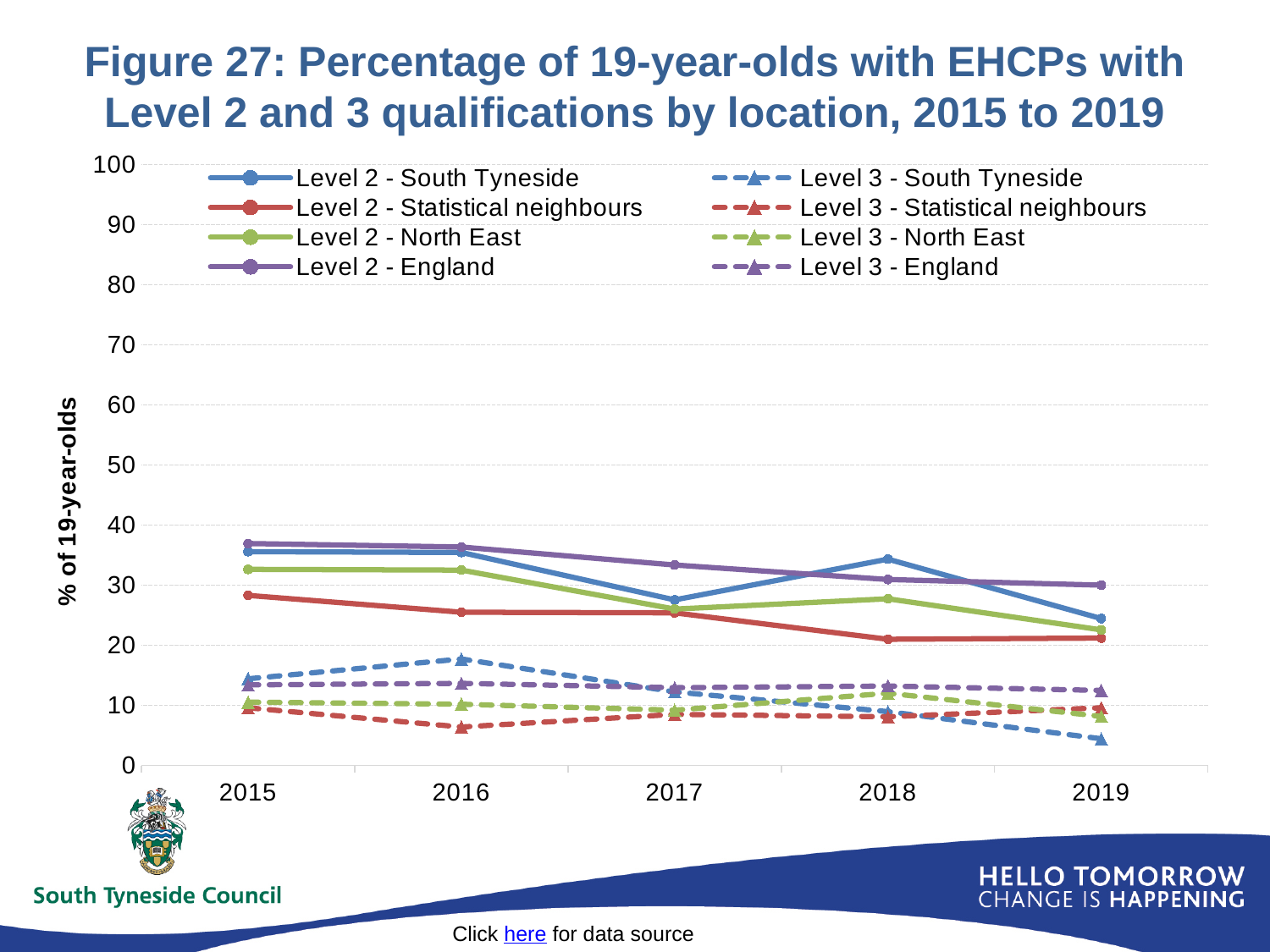
Is the value for Level 3 - Statistical neighbours in 2016 greater or less than 10? less How many series does the legend list? 8 Does the Level 2 - Statistical neighbours line rise or fall from 2015 to 2019? Fall What kind of chart is shown on the slide? Line chart Is the value for Level 2 - England in 2015 greater or less than 30? greater In 2016, which is larger: Level 3 - South Tyneside or Level 3 - North East? Level 3 - South Tyneside How many years are plotted along the x axis? 5 What is the label on the vertical axis? % of 19-year-olds Which years does the chart cover, according to the x axis? 2015 to 2019 Is the value for Level 3 - South Tyneside in 2019 greater or less than 10? less Which series has the lowest value in 2019? Level 3 - South Tyneside In 2019, which is larger: Level 2 - England or Level 2 - South Tyneside? Level 2 - England